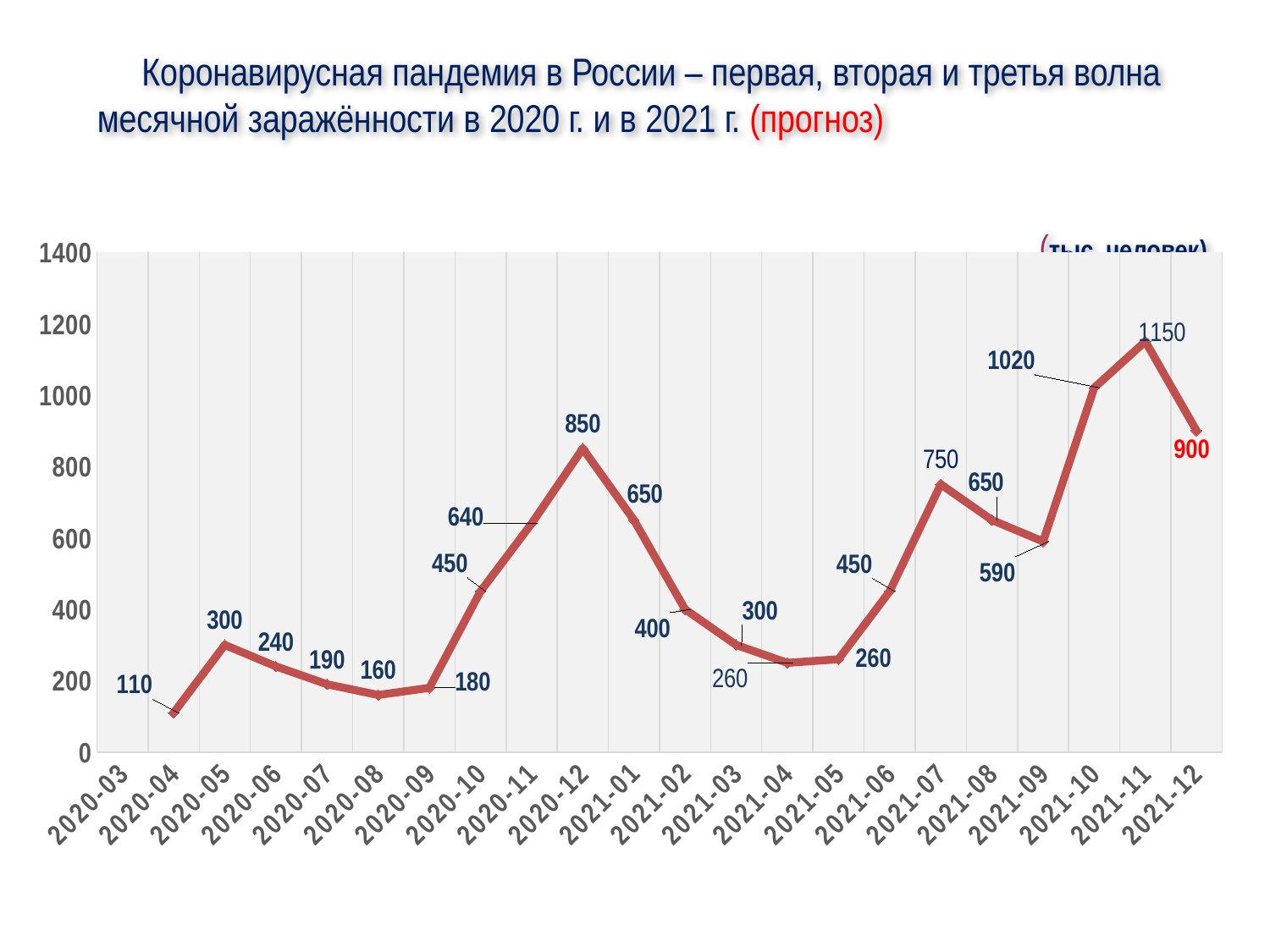
Do the values rise or fall from 2021-09 to 2021-11? rise What type of chart is shown on the slide? line chart What is the highest value plotted on the chart? 1150 Which month has the highest value on the chart? 2021-11 What is the value for 2020-12? 850 Is the value for 2021-12 greater or less than 1000? less Which is larger, the value for 2020-12 or the value for 2021-10? 2021-10 What is the difference between the value for 2021-11 and the value for 2020-12? 300 What is the difference between the value for 2021-07 and the value for 2021-08? 100 What is the lowest value plotted on the chart? 110 What is the value for 2021-07? 750 What is the value for 2021-02? 400